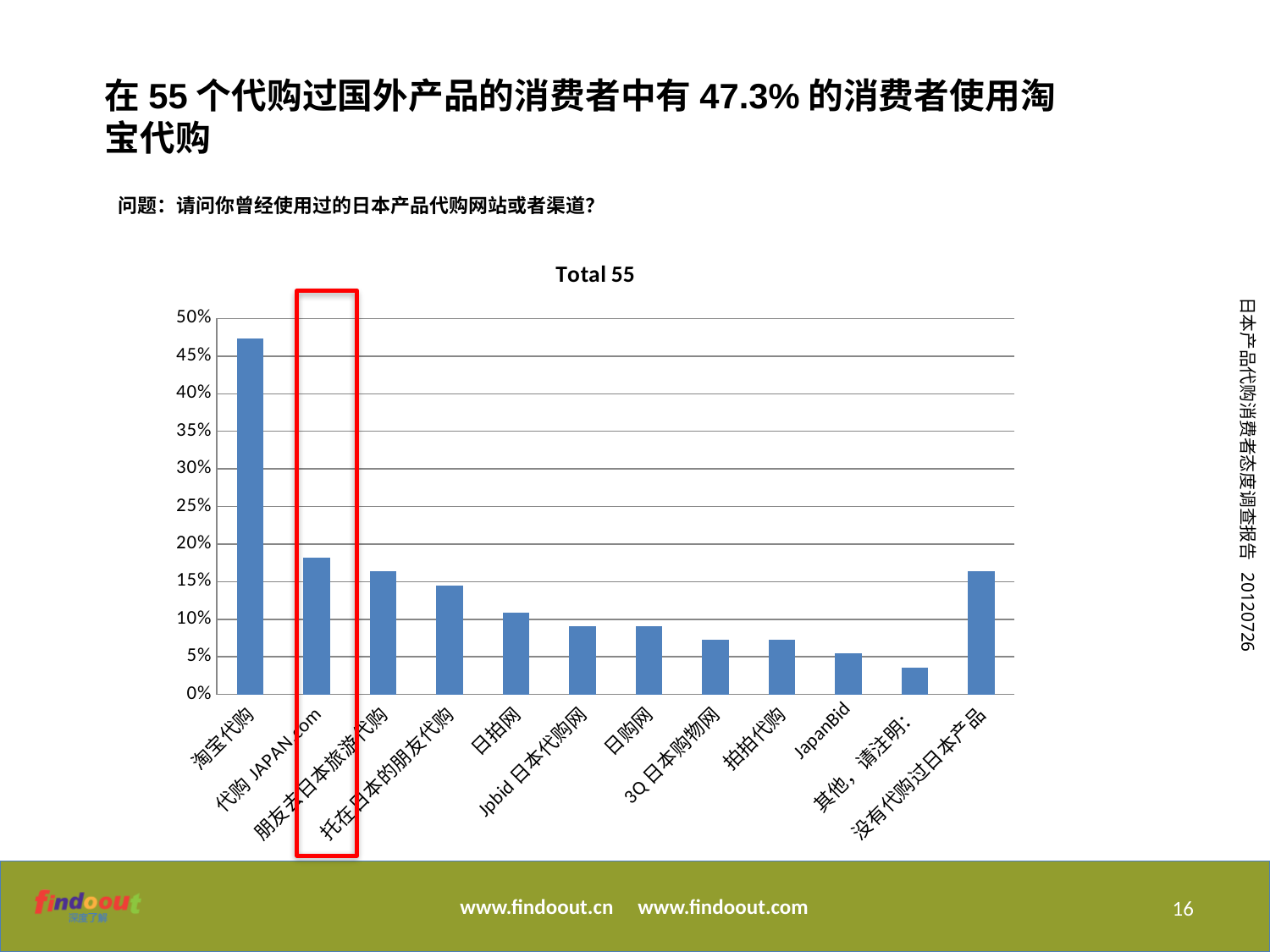
What is the title of the chart? Total 55 Which is larger, the value for 淘宝代购 or the value for 代购 JAPAN.com? 淘宝代购 Is the value for 没有代购过日本产品 greater or less than 15%? greater According to the slide, what percentage of consumers used 淘宝代购? 47.3% Is the value for 拍拍代购 greater or less than 10%? less Which category has the highest value in the chart? 淘宝代购 Which category has the lowest value in the chart? 其他，请注明: Is the value for 代购 JAPAN.com greater or less than 15%? greater Which category is highlighted with a red box on the chart? 代购 JAPAN.com What kind of chart is shown on the slide? bar chart How many categories are shown on the x axis of the chart? 12